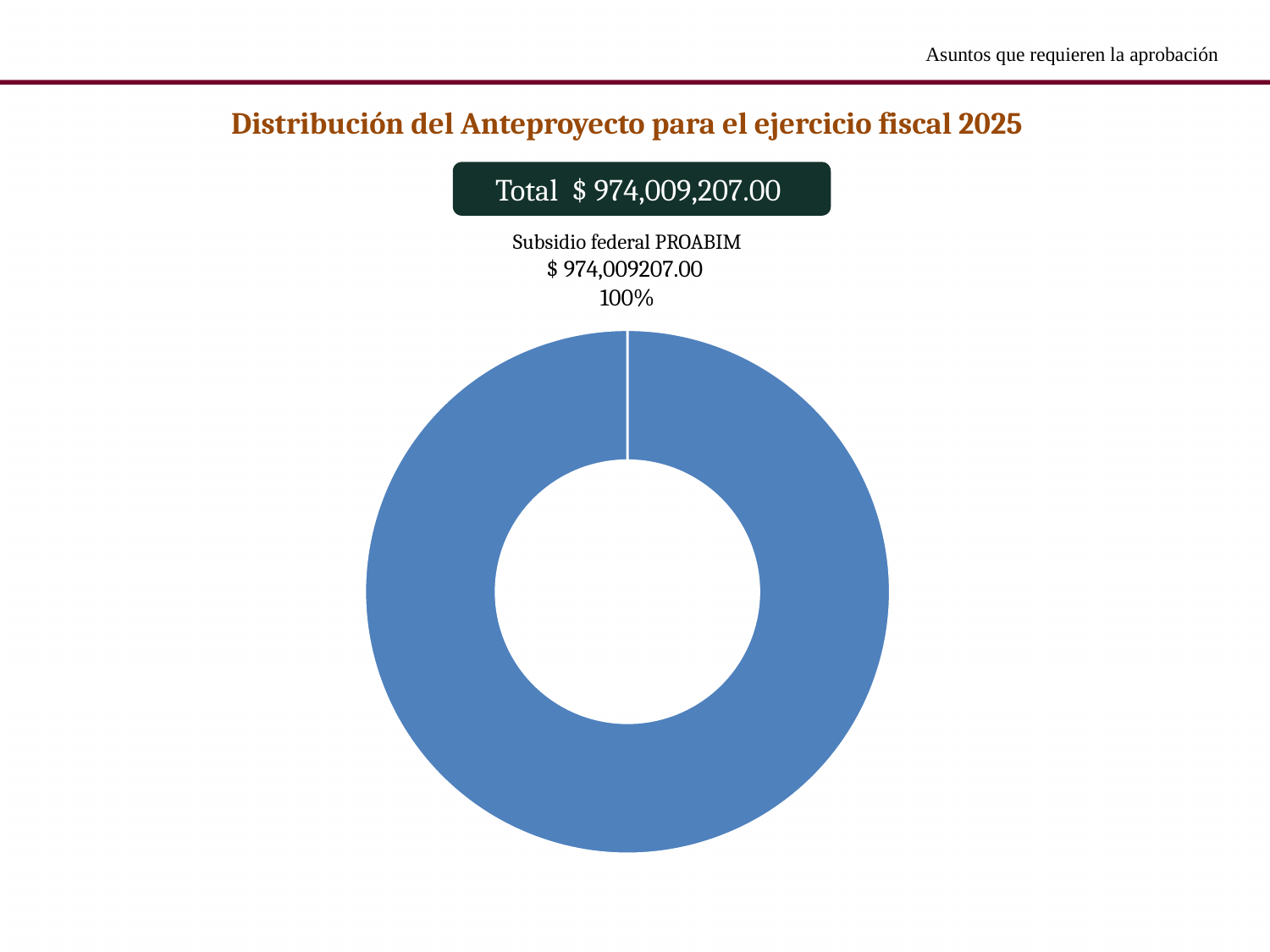
What is the title of the chart on the slide? Distribución del Anteproyecto para el ejercicio fiscal 2025 What total amount is shown in the box above the chart? $ 974,009,207.00 What colour is the single slice of the doughnut chart? Blue What kind of chart is shown on the slide? Doughnut (pie) chart What share of the doughnut chart does Subsidio federal PROABIM represent? 100% What is the name of the only category shown in the doughnut chart? Subsidio federal PROABIM How many categories (slices) does the doughnut chart contain? 1 What value is printed on the chart for Subsidio federal PROABIM? $ 974,009207.00